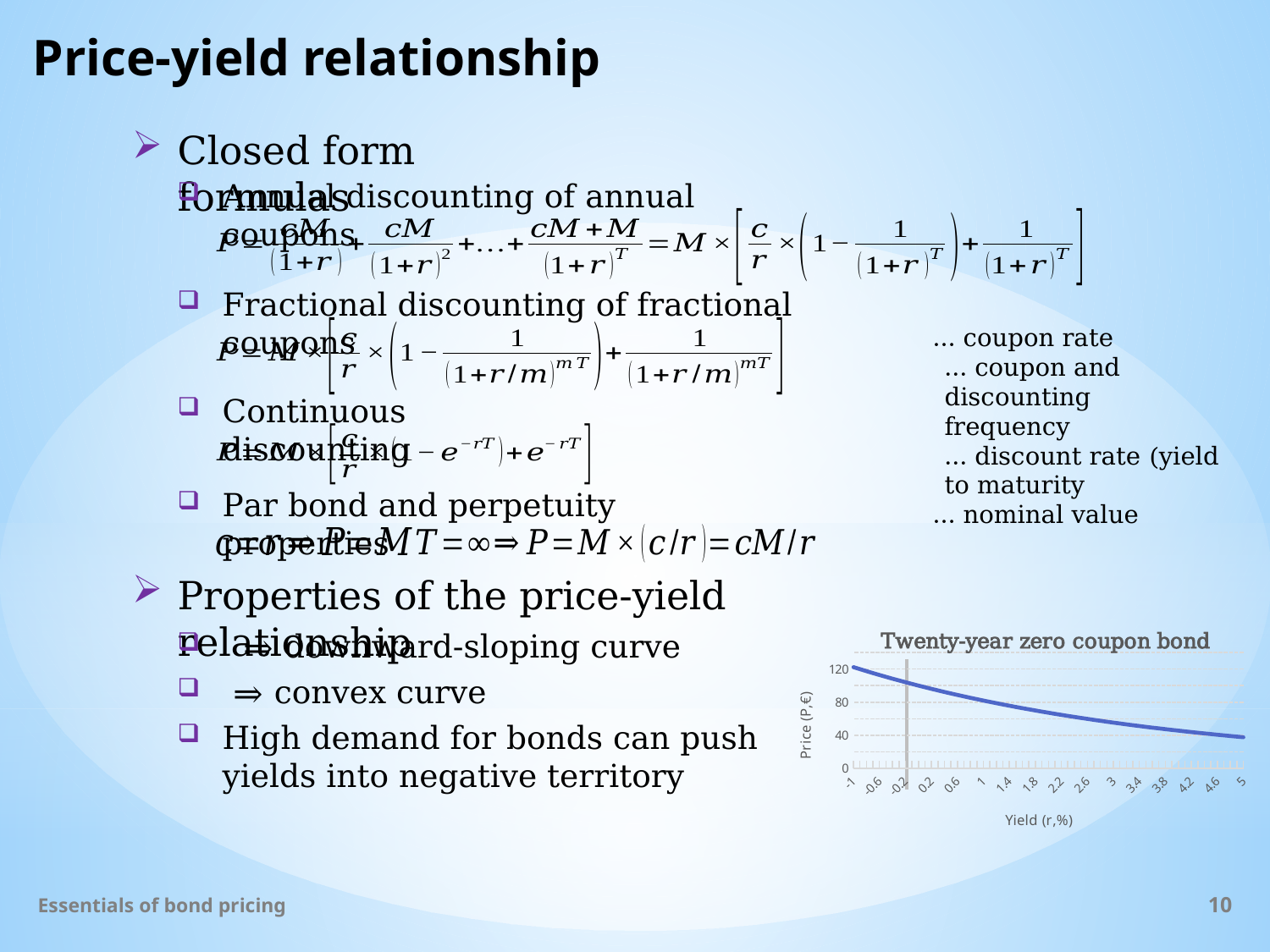
What kind of chart is shown on the slide? line chart Which yield gives the higher price, 1% or 4.2%? 1% Does the price rise or fall as the yield increases along the x axis? fall At which yield shown on the x axis is the price lowest? 5 Is the price at a yield of 2.2% greater or less than 80? less What is the label of the vertical axis of the chart? Price (P,€) At which yield shown on the x axis is the price highest? -1 How many yield tick labels are shown on the x axis? 16 Is the price at a yield of 3% greater or less than 80? less What is the title of the chart? Twenty-year zero coupon bond Is the price at a yield of 0.2% greater or less than 80? greater